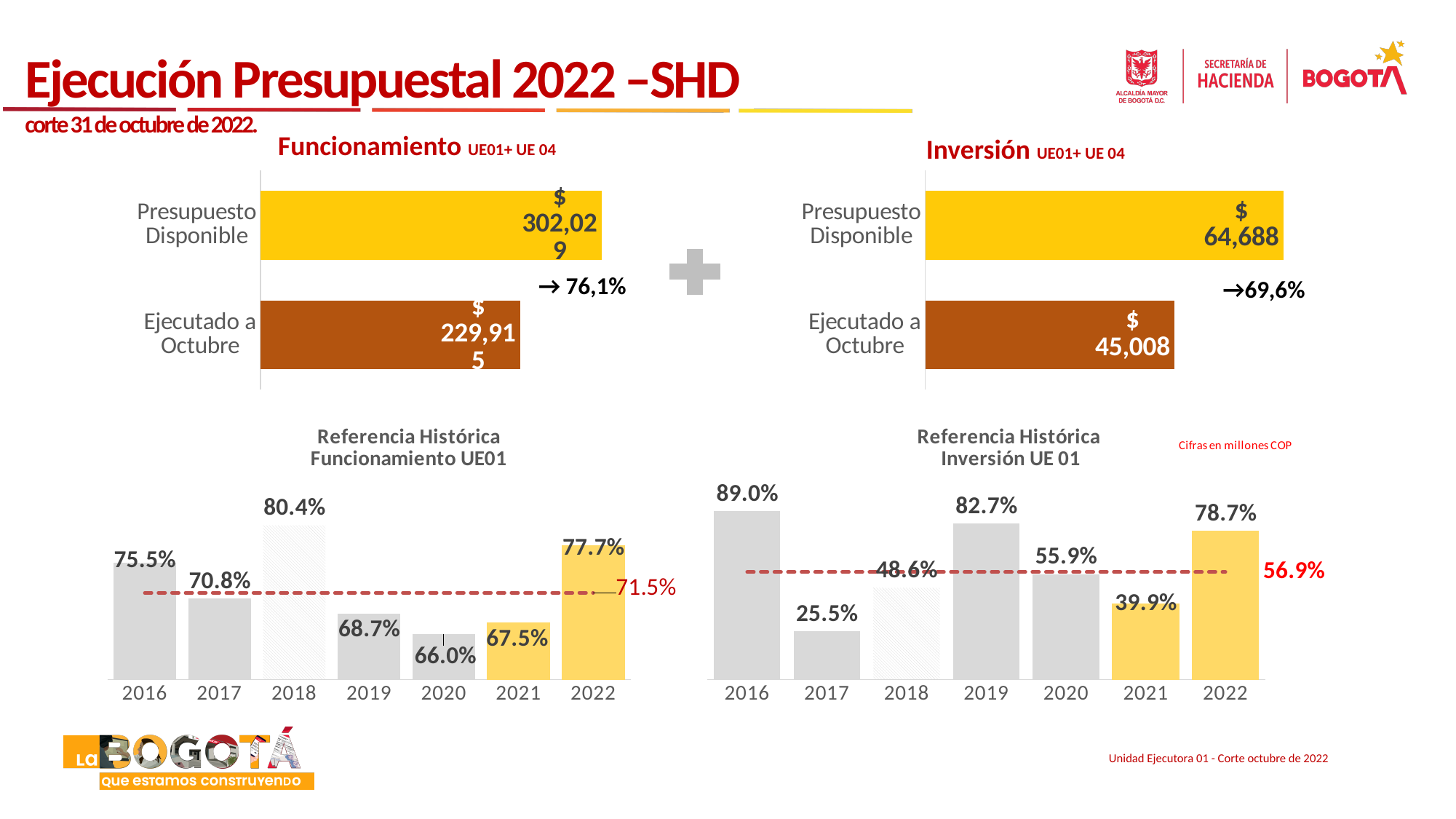
In the 'Referencia Histórica Funcionamiento UE01' chart, what is the difference between 2022 and 2021? 10.2% In the 'Funcionamiento UE01+ UE 04' chart, what is the value for Presupuesto Disponible? $ 302,029 In the 'Inversión UE01+ UE 04' chart, what is the value for Ejecutado a Octubre? $ 45,008 In the 'Referencia Histórica Funcionamiento UE01' chart, what is the value for 2018? 80.4% In the 'Referencia Histórica Inversión UE 01' chart, how many years are shown on the x axis? 7 In the 'Referencia Histórica Inversión UE 01' chart, which year has the highest value? 2016 In the 'Referencia Histórica Inversión UE 01' chart, what value does the dashed reference line mark? 56.9% In the 'Referencia Histórica Inversión UE 01' chart, what is the value for 2017? 25.5% In the 'Funcionamiento UE01+ UE 04' chart, which is larger, Presupuesto Disponible or Ejecutado a Octubre? Presupuesto Disponible What kind of chart is the 'Referencia Histórica Inversión UE 01' chart? Bar chart In the 'Referencia Histórica Funcionamiento UE01' chart, which year has the lowest value? 2020 In the 'Inversión UE01+ UE 04' chart, what is the difference between Presupuesto Disponible and Ejecutado a Octubre? 19,680